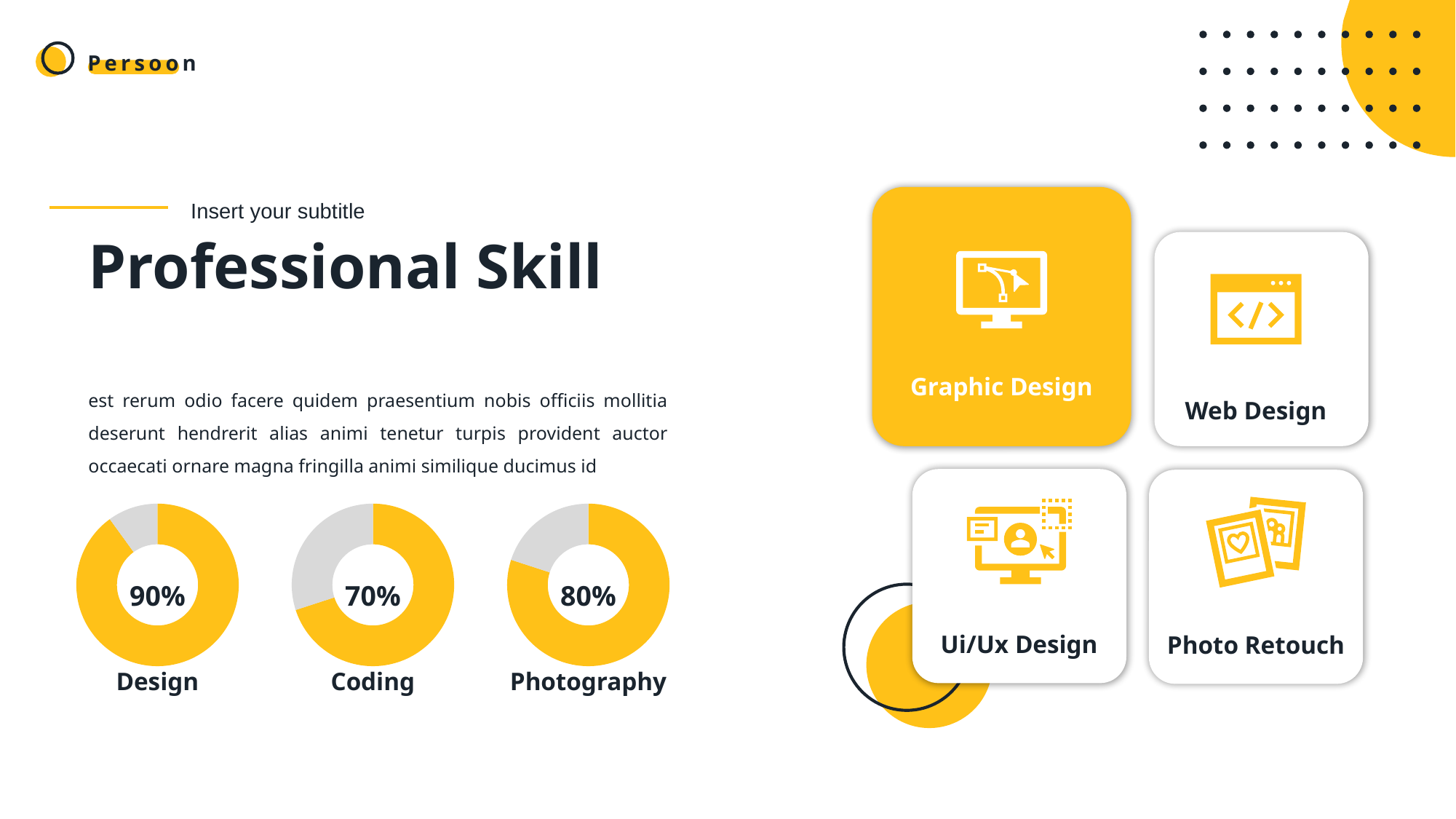
What is the title of the slide containing the skill charts? Professional Skill Which is larger, the Coding value or the Photography value? Photography What is the difference between the Design and Coding percentages? 20% How many doughnut charts are shown on the slide? 3 What value is shown in the Photography doughnut chart? 80% What kind of chart is used to show the skill percentages? Doughnut chart Which of the three skill charts shows the highest percentage? Design What value is shown in the Coding doughnut chart? 70% What is the difference between the Photography and Coding percentages? 10% What value is shown in the Design doughnut chart? 90% What colour is the filled portion of each doughnut chart? Yellow Which of the three skill charts shows the lowest percentage? Coding